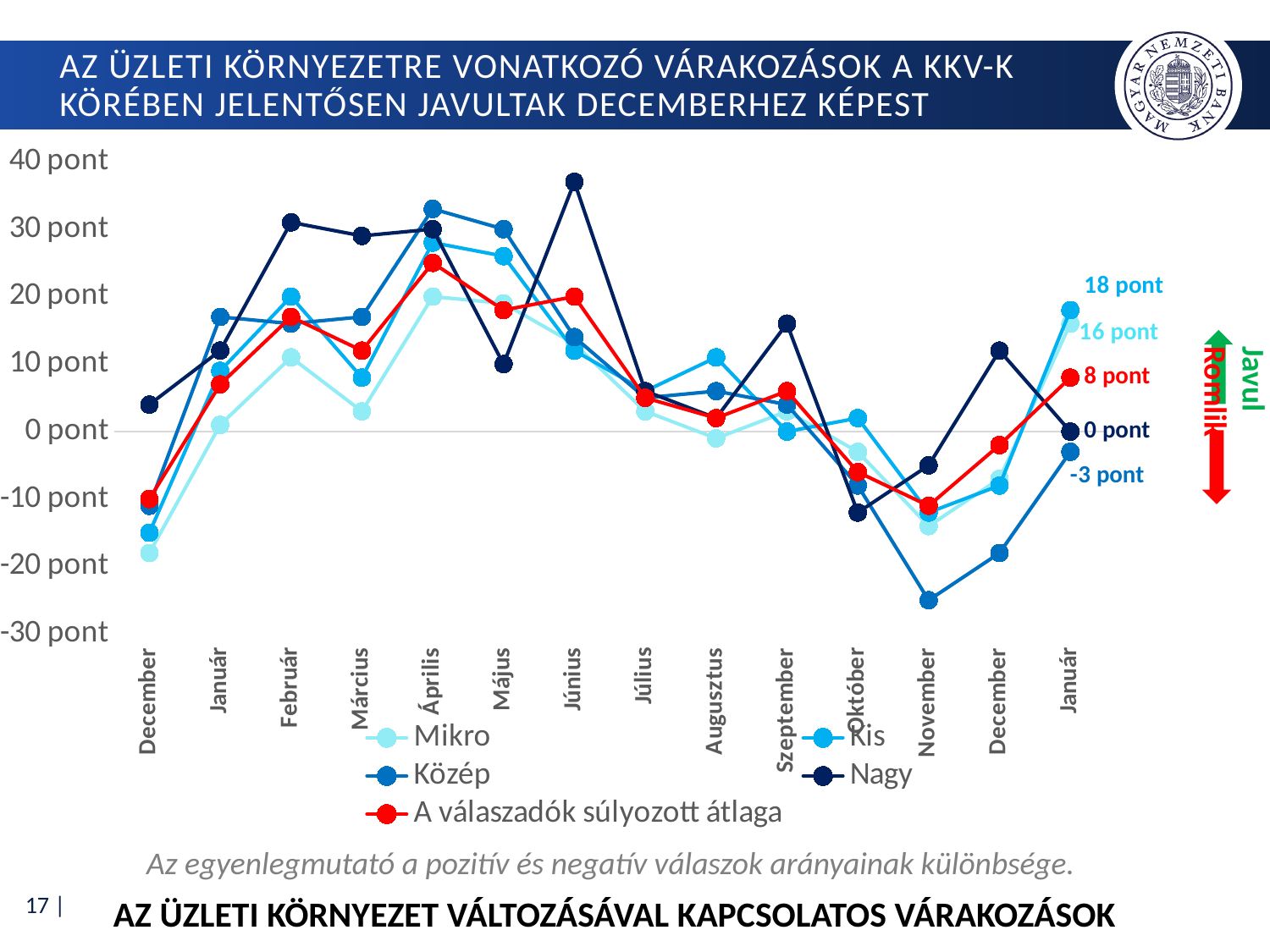
What value does the Közép series show for the final Január point? -3 pont What value does the Mikro series show for the final Január point? 16 pont At the final Január point, which is larger: the Mikro value or the 'A válaszadók súlyozott átlaga' value? Mikro What value does the Kis series show for the final Január point? 18 pont Which series has the highest value at the final Január point? Kis Which series has the lowest value at the final Január point? Közép What value does the 'A válaszadók súlyozott átlaga' series show for the final Január point? 8 pont How many series does the legend list? 5 Is the value for the Közép series in November greater or less than -20 pont? less At the final Január point, what is the difference between the Kis value and the Közép value? 21 pont What kind of chart is shown on the slide? line chart Is the value for the Nagy series in Június greater or less than 30 pont? greater